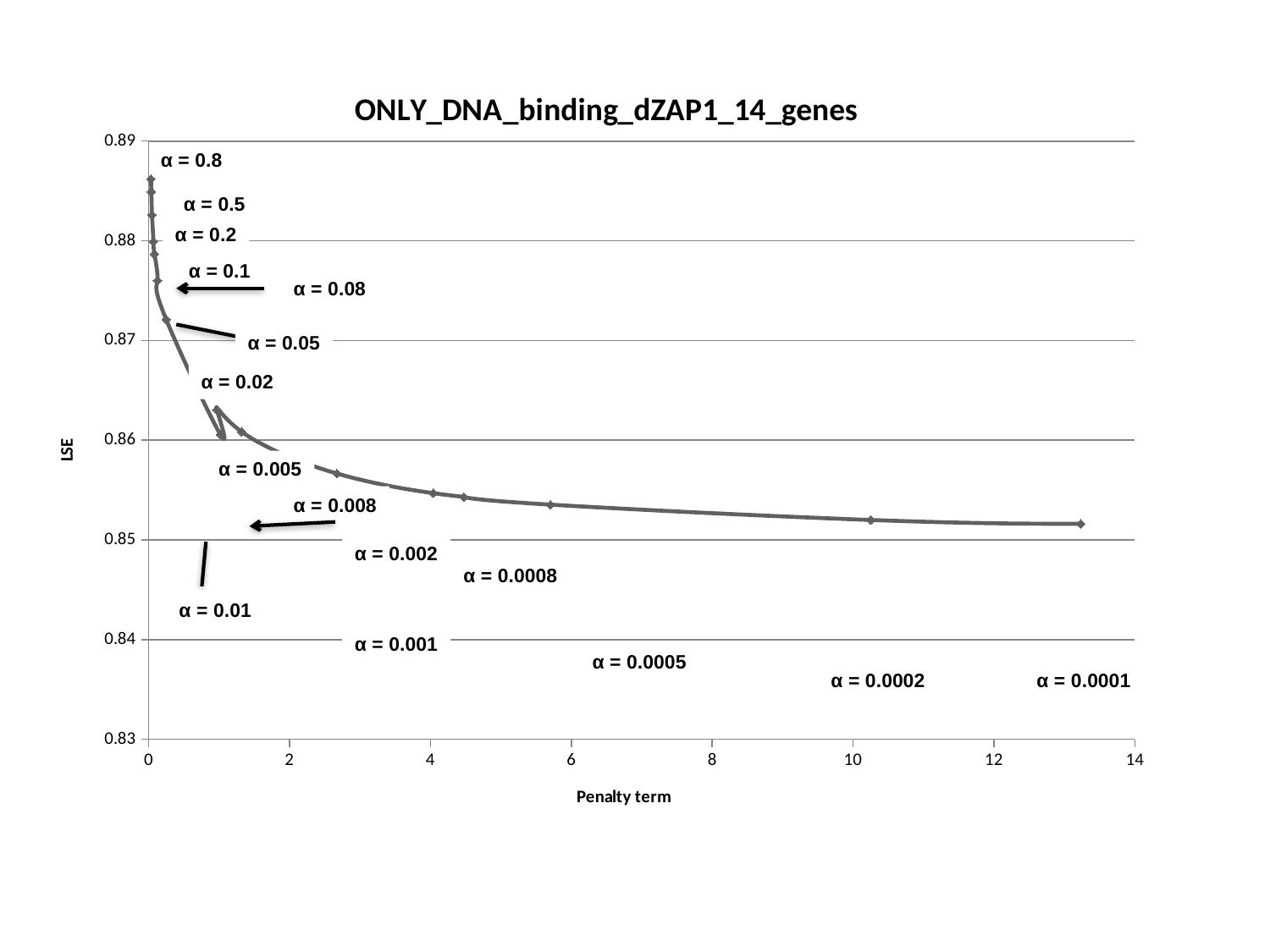
Is the penalty term for α = 0.0002 greater or less than 8? greater Is the LSE for α = 0.0001 greater or less than 0.86? less Which labelled α value has the highest LSE? α = 0.8 What is the title of the chart? ONLY_DNA_binding_dZAP1_14_genes Is the penalty term for α = 0.0001 greater or less than 12? greater Which has a higher LSE, α = 0.1 or α = 0.002? α = 0.1 How many α values are labelled on the chart? 16 What kind of chart is shown on the slide? line chart What is the label of the x axis? Penalty term Which labelled α value has the largest penalty term? α = 0.0001 As the penalty term increases along the x axis, does LSE rise or fall? fall